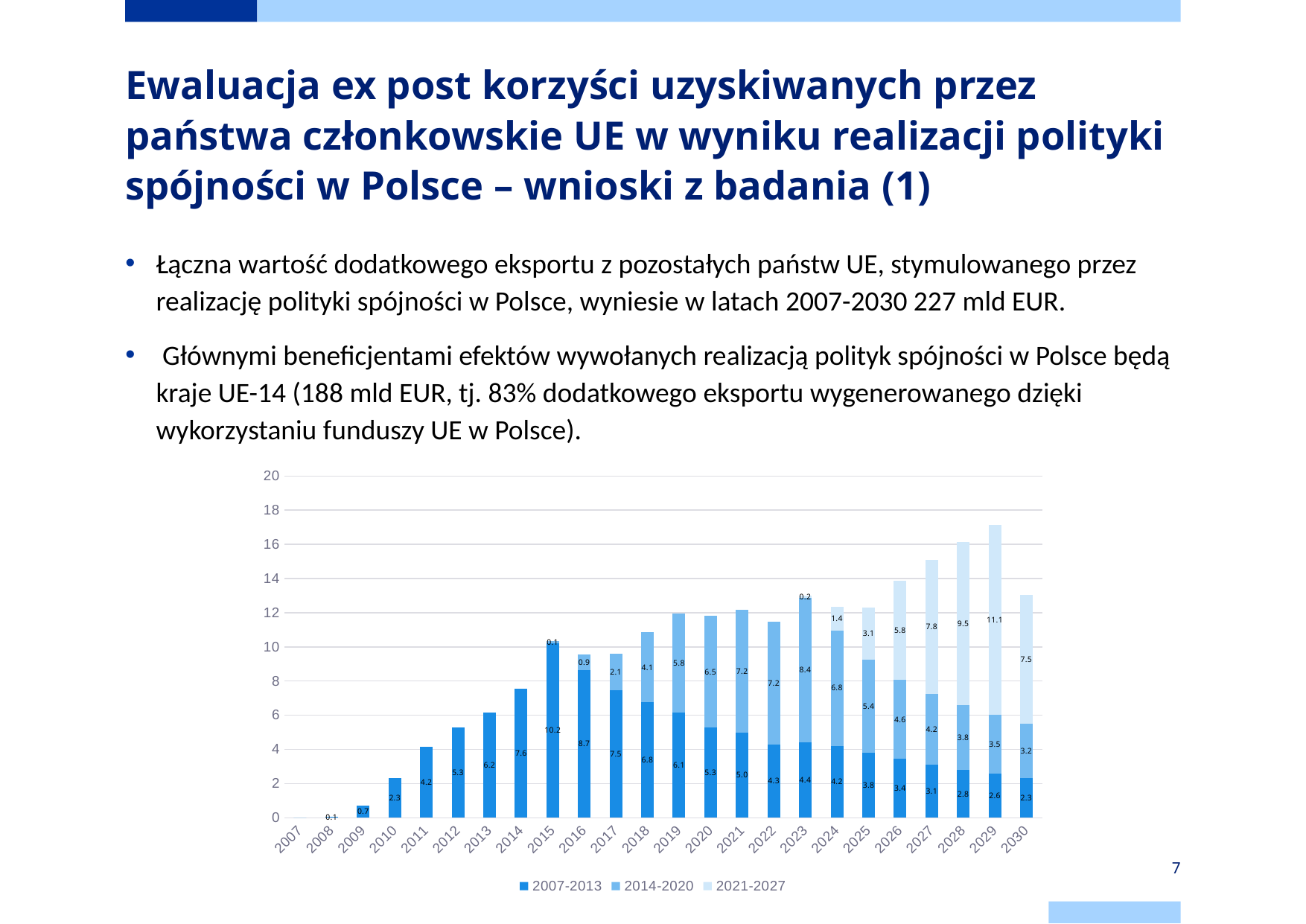
Does the 2007-2013 series rise or fall from 2015 to 2030? fall What is the value of the 2007-2013 series for 2015? 10.2 What kind of chart is shown on the slide? stacked bar chart What is the value of the 2021-2027 series for 2029? 11.1 What is the difference between the 2021-2027 values for 2029 and 2030? 3.6 How many years are shown on the x axis of the chart? 24 How many series does the chart legend list? 3 What is the total of the stacked bar for 2030? 13.0 What is the value of the 2014-2020 series for 2023? 8.4 Which is larger: the 2014-2020 value for 2021 or the 2014-2020 value for 2025? 2021 Which year has the tallest stacked bar overall? 2029 In which year does the 2007-2013 series reach its highest value? 2015